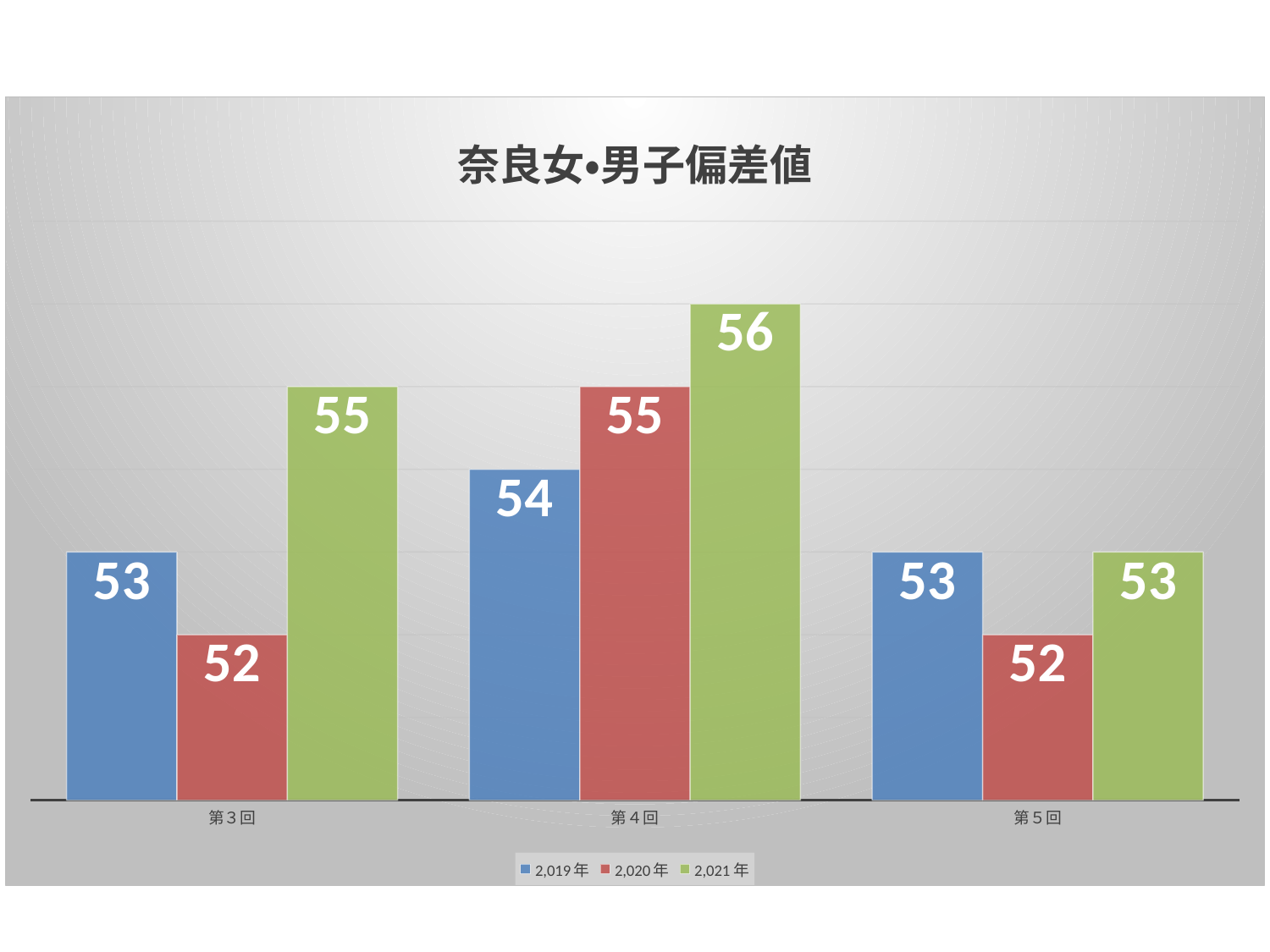
Which category has the highest value for the 2,021 年 series? 第4回 Which category has the lowest value for the 2,019 年 series? 第3回 and 第5回 (both 53) What is the value for 2,021 年 in 第5回? 53 Which colour represents the 2,020 年 series? Red What kind of chart is shown on the slide? Bar chart How many categories are shown on the x axis? 3 What is the difference between the 2,021 年 and 2,020 年 values in 第3回? 3 What is the title of the chart? 奈良女•男子偏差値 What is the value for 2,020 年 in 第4回? 55 What is the value for 2,019 年 in 第3回? 53 How many series does the legend list? 3 Which is larger in 第4回: the 2,019 年 value or the 2,021 年 value? 2,021 年